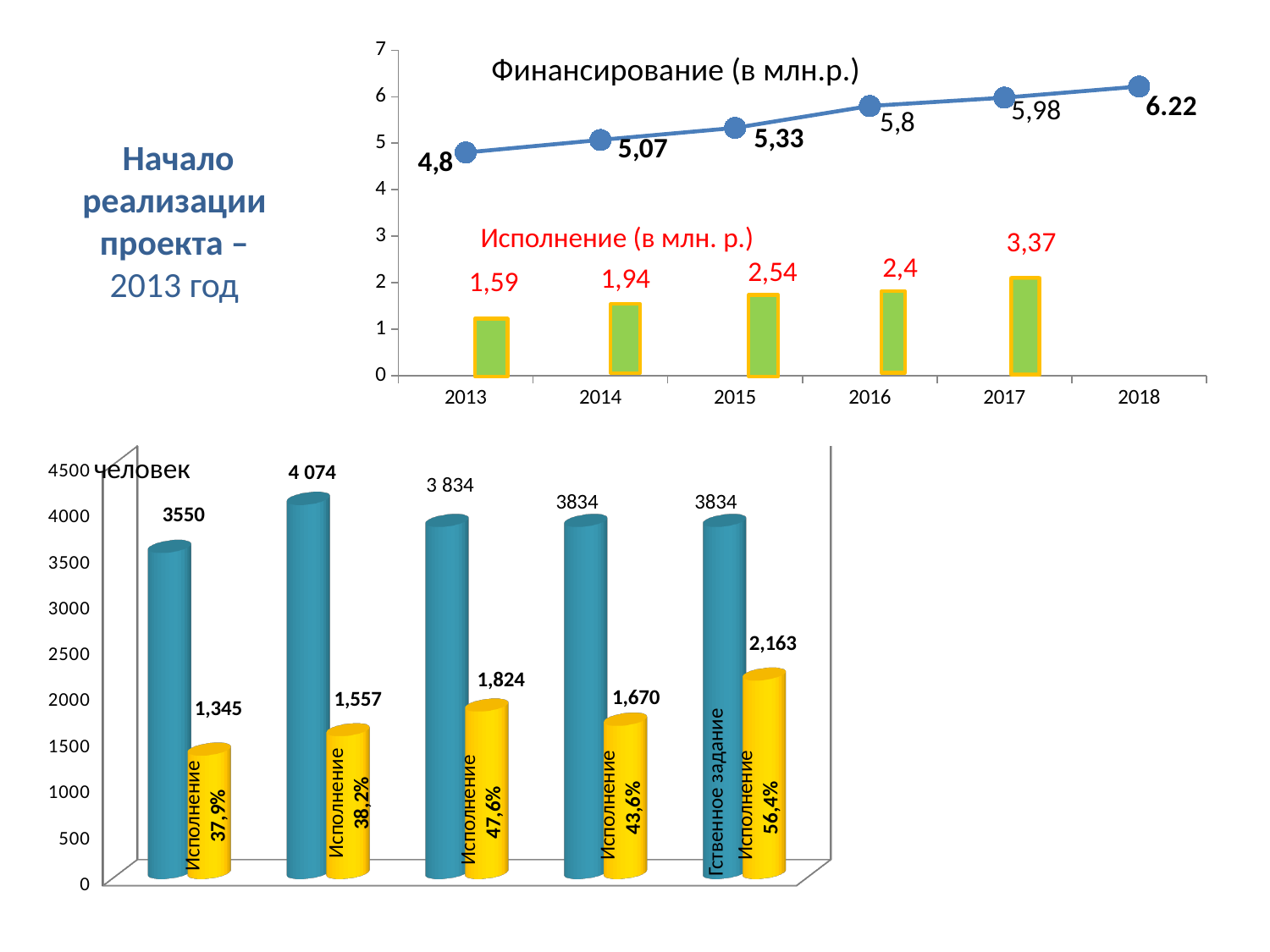
In the top chart, what is the Финансирование value for 2015? 5,33 In the top chart, what is the Исполнение value for 2017? 3,37 In the bottom chart, what is the value of the tallest blue bar? 4 074 In the top chart, which year has the highest Исполнение value? 2017 In the top chart, does the Финансирование line rise or fall from 2013 to 2018? rises In the top chart, what is the difference between the Финансирование values for 2018 and 2013? 1,42 In the top chart, which year has the larger Исполнение value, 2015 or 2016? 2015 In the top chart, how many years are shown on the x axis? 6 In the top chart, which year has the lowest Финансирование value? 2013 In the top chart, is the Исполнение value for 2014 greater or less than 2? less In the bottom chart, what is the highest Исполнение percentage shown? 56,4% What kind of chart is the bottom chart? bar chart